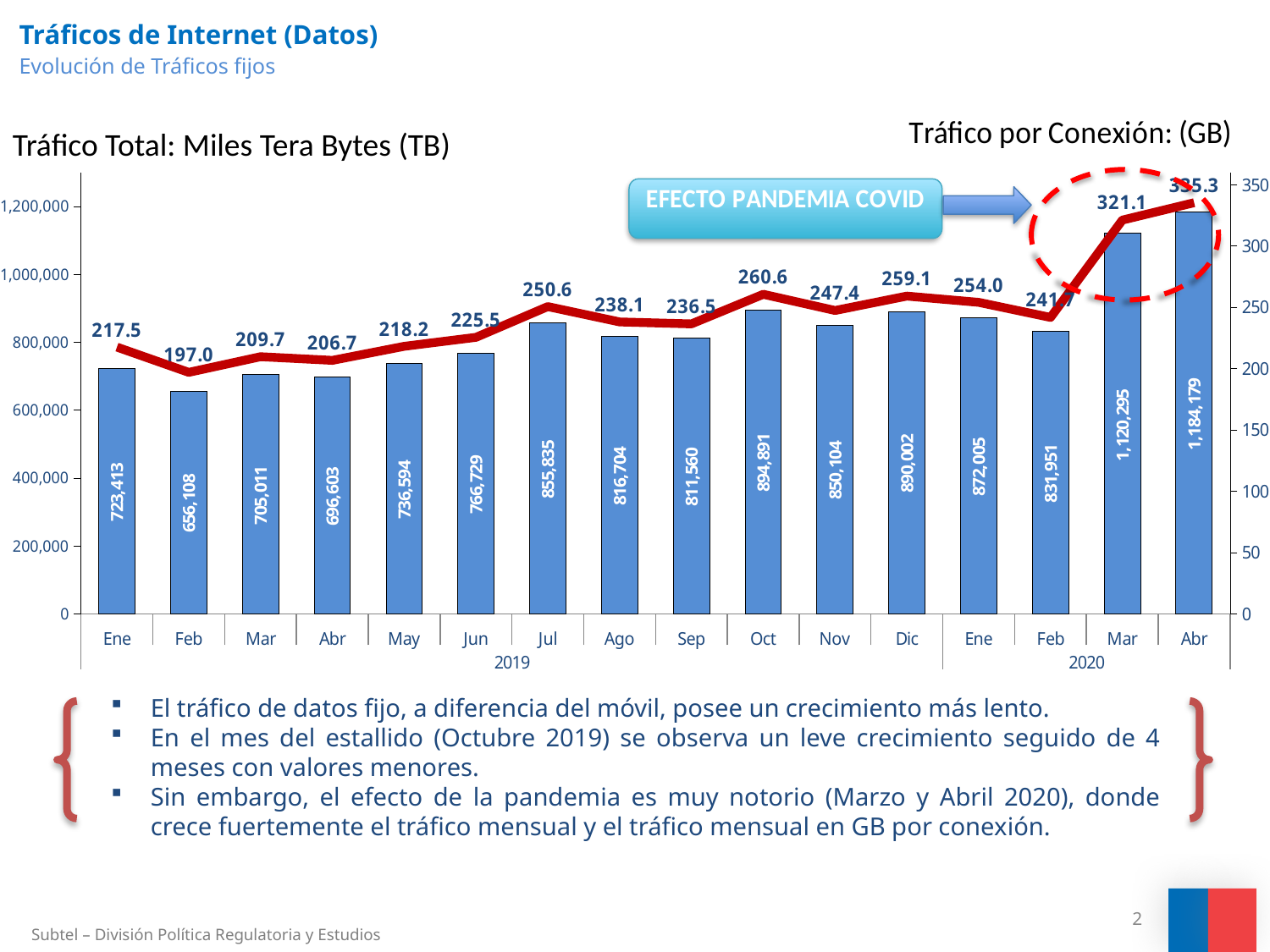
What is the difference in total fixed traffic between Abr 2020 and Mar 2020? 63,884 Is the total fixed traffic for Ene 2020 greater or less than 1,000,000? less What is the difference in traffic per connection (GB) between Oct 2019 and Sep 2019? 24.1 What is the total fixed traffic (Miles TB) for Oct 2019? 894,891 Which month has the larger total fixed traffic, Nov 2019 or Dic 2019? Dic 2019 What is the traffic per connection (GB) for Jul 2019? 250.6 Which month has the highest total fixed traffic bar? Abr 2020 What text appears in the callout box pointing to the Mar and Abr 2020 values? EFECTO PANDEMIA COVID How many months are plotted on the chart? 16 What is the total fixed traffic (Miles TB) for Abr 2020? 1,184,179 Which month has the lowest total fixed traffic bar? Feb 2019 What is the traffic per connection (GB) for Mar 2020? 321.1